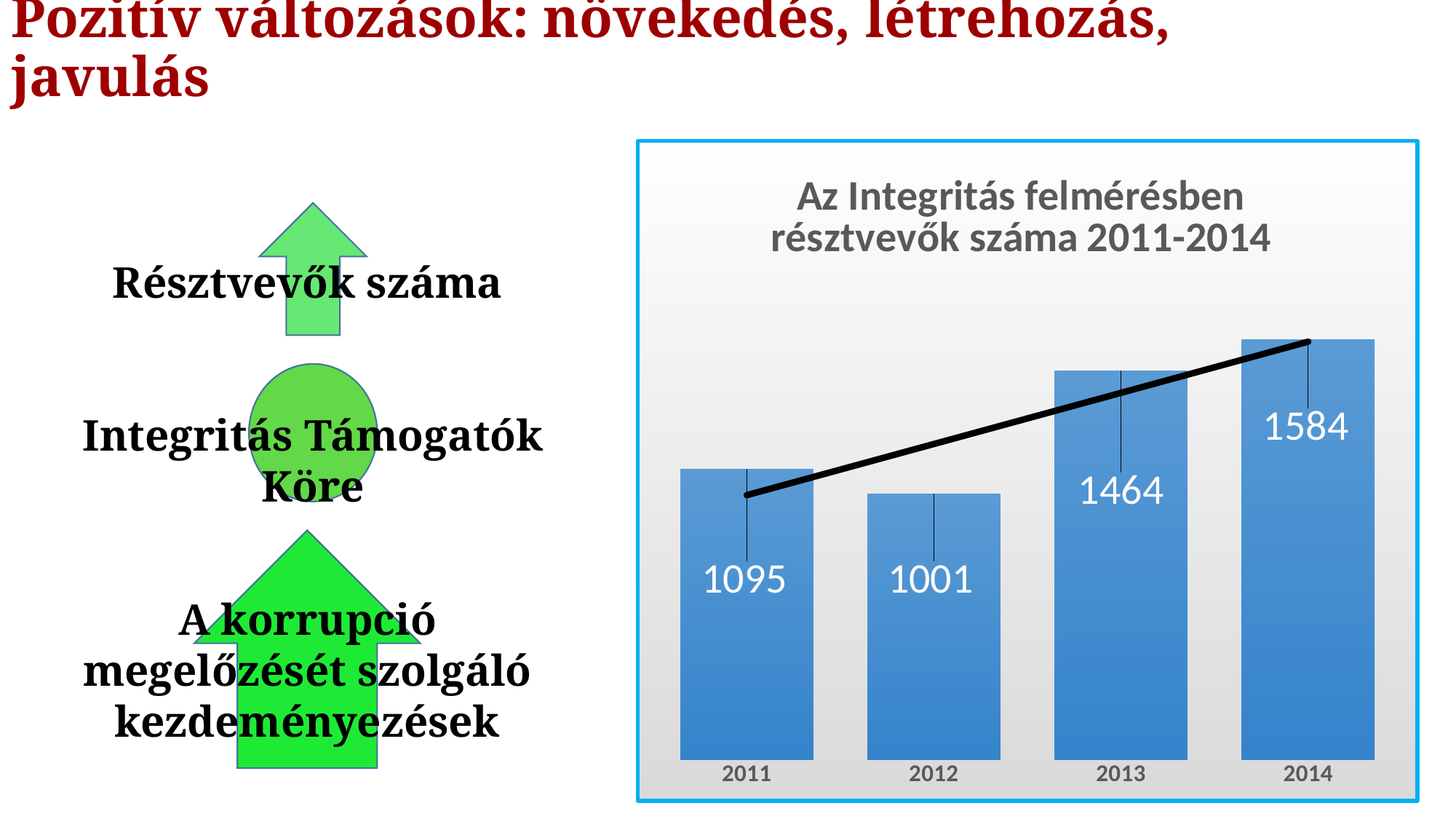
Which is larger, the value for 2011 or the value for 2012? 2011 What is the value for 2012? 1001 Which year has the lowest value? 2012 What kind of chart is this? bar chart What is the title of the chart? Az Integritás felmérésben résztvevők száma 2011-2014 What is the value for 2011? 1095 What is the difference between the values for 2013 and 2012? 463 Which year has the highest value? 2014 What is the value for 2013? 1464 What is the difference between the values for 2014 and 2011? 489 What is the value for 2014? 1584 How many years are shown on the x axis? 4